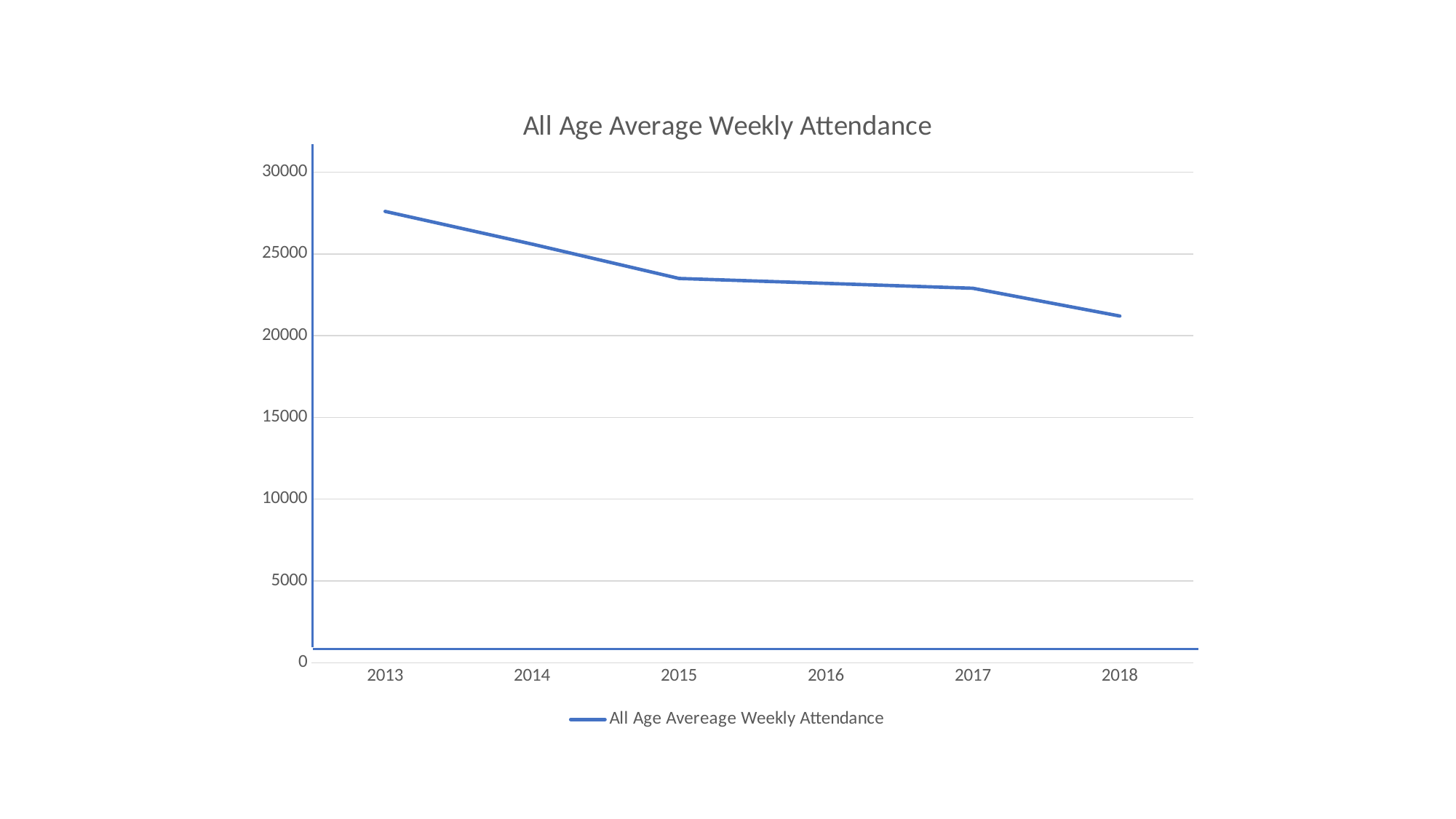
Is the value for 2013 greater or less than 25000? greater Is the value for 2018 greater or less than 25000? less Which year has the lowest average weekly attendance? 2018 Is the value for 2018 greater or less than 20000? greater How many years are shown on the x axis? 6 Which year has the larger value, 2013 or 2018? 2013 How many series does the legend list? 1 What is the title of the chart? All Age Average Weekly Attendance Which year has the highest average weekly attendance? 2013 Do the values rise or fall from 2013 to 2018? fall What kind of chart is shown on the slide? line chart